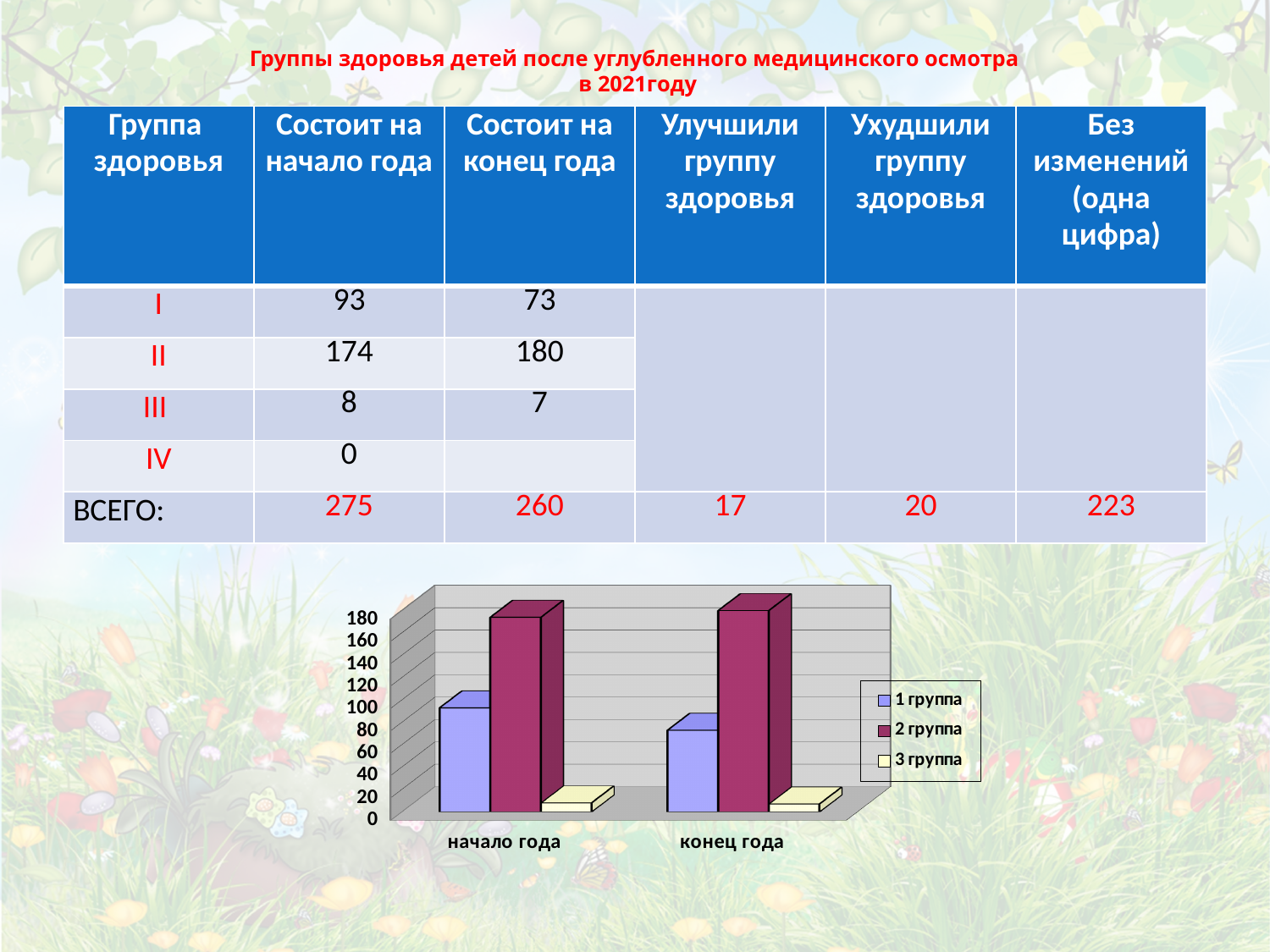
Is the value for 1 группа at конец года greater or less than 100? less Does the value for 1 группа rise or fall from начало года to конец года? fall How many series does the chart legend list? 3 Which is larger for 1 группа: the bar for начало года or the bar for конец года? начало года Which series has the tallest bar for начало года? 2 группа How many categories are shown on the x axis of the chart? 2 Is the value for 3 группа at конец года greater or less than 20? less What kind of chart is shown on the slide? bar chart Which series has the shortest bar for конец года? 3 группа Is the value for 1 группа at начало года greater or less than 60? greater What colour are the bars for 2 группа in the chart? magenta